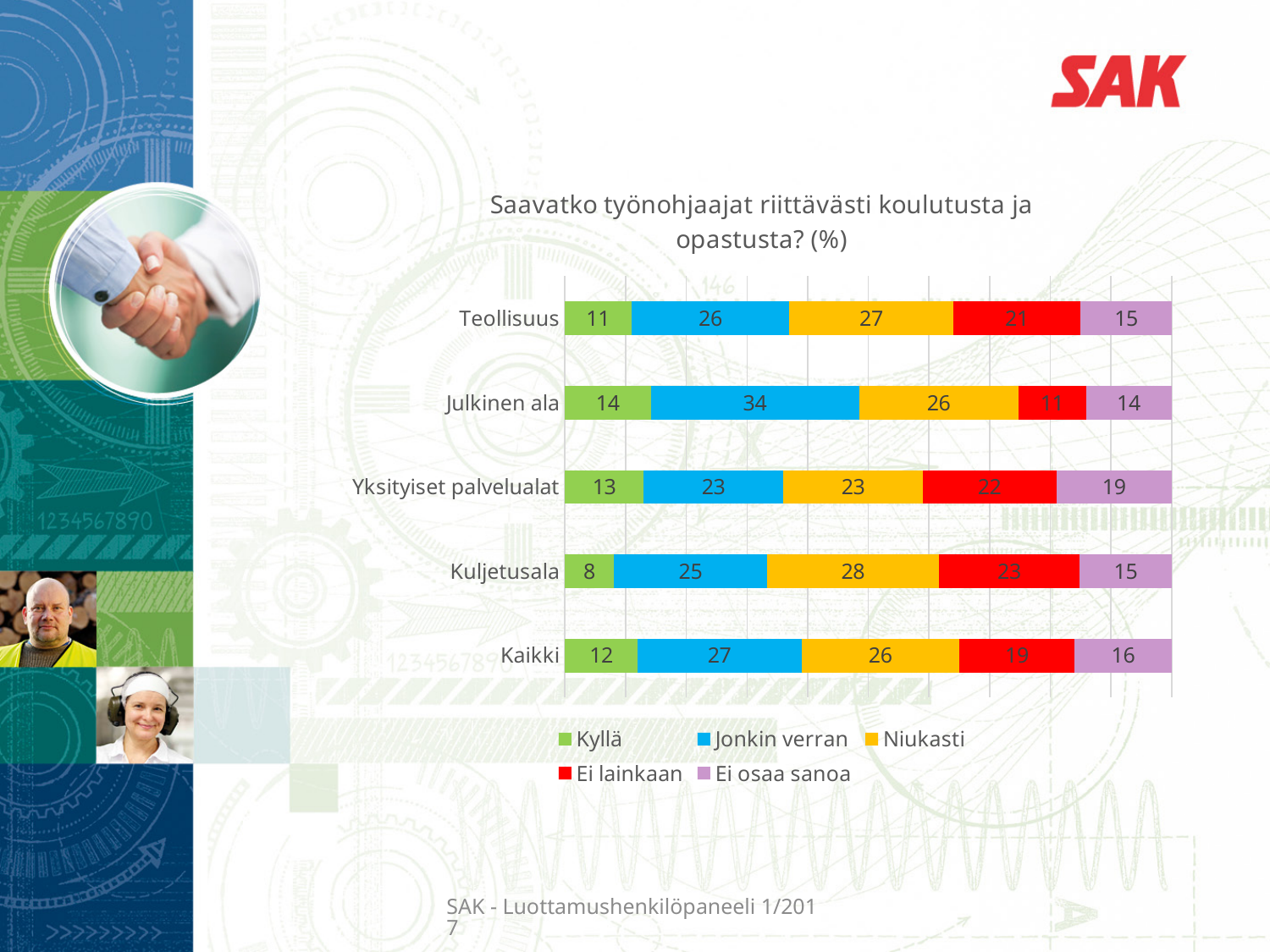
Which category has the lowest 'Kyllä' value? Kuljetusala What is the total of the stacked bar for Yksityiset palvelualat? 100 What is the difference between the 'Ei lainkaan' values for Kuljetusala and Julkinen ala? 12 What is the 'Kyllä' value for Julkinen ala? 14 What kind of chart is shown on the slide? Stacked bar chart How many series does the legend list? 5 What is the 'Ei lainkaan' value for Yksityiset palvelualat? 22 What is the 'Jonkin verran' value for Kuljetusala? 25 What is the title of the chart? Saavatko työnohjaajat riittävästi koulutusta ja opastusta? (%) Which category has the highest 'Jonkin verran' value? Julkinen ala How many categories are shown on the chart? 5 Which is larger, the 'Niukasti' value for Teollisuus or for Kaikki? Teollisuus